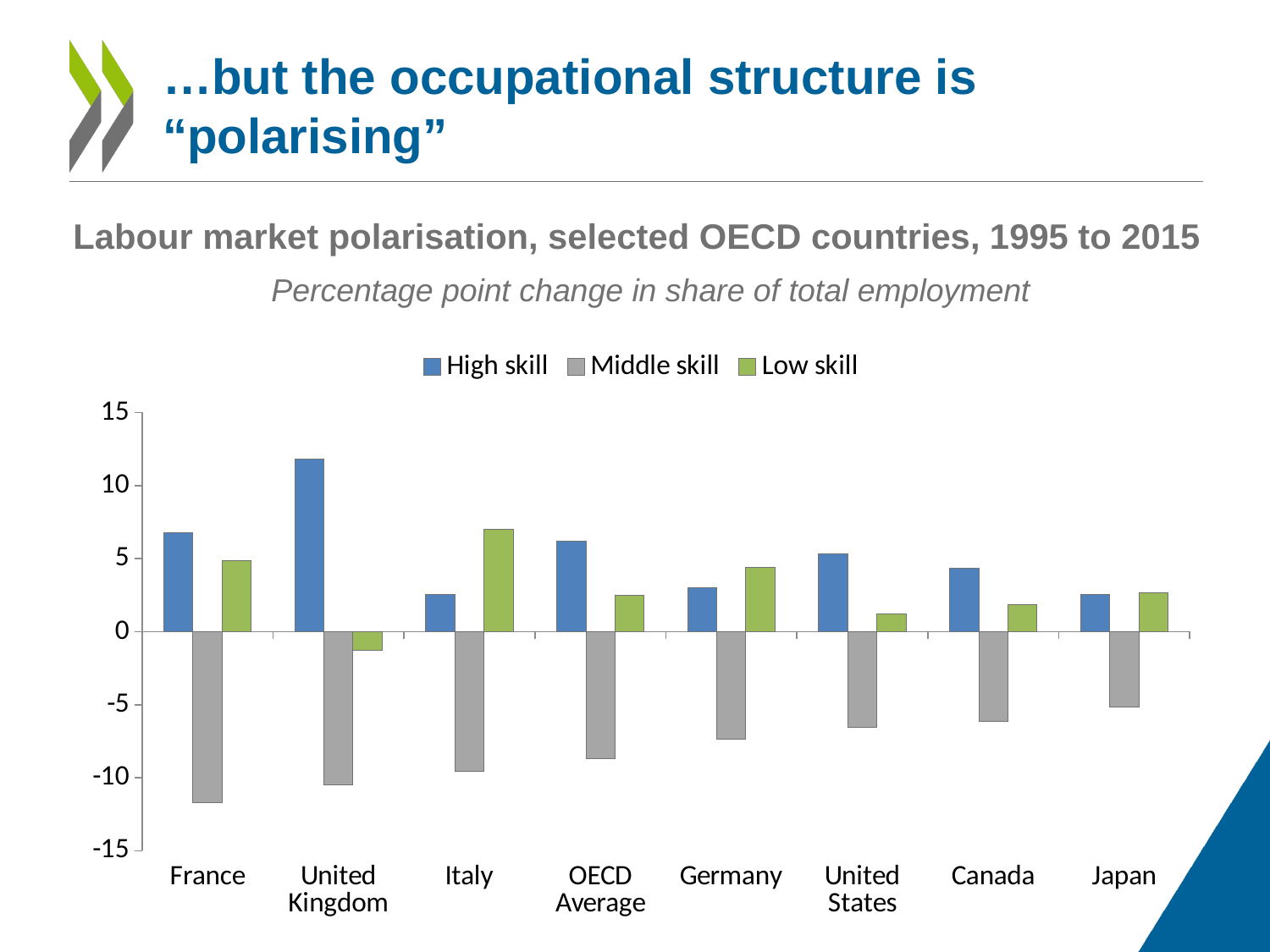
How many countries/categories are shown on the x axis? 8 Which is larger, the High skill value for France or the High skill value for Italy? France Which category has the highest Low skill value? Italy Which category has the highest High skill value? United Kingdom Which series is shown in green in the legend? Low skill How many series does the legend list? 3 Is the Low skill value for Italy greater or less than 5? greater Which category has the lowest (most negative) Middle skill value? France Is the Middle skill value for Germany greater or less than -5? less Is the Middle skill value for France greater or less than -10? less What kind of chart is shown on the slide? bar chart